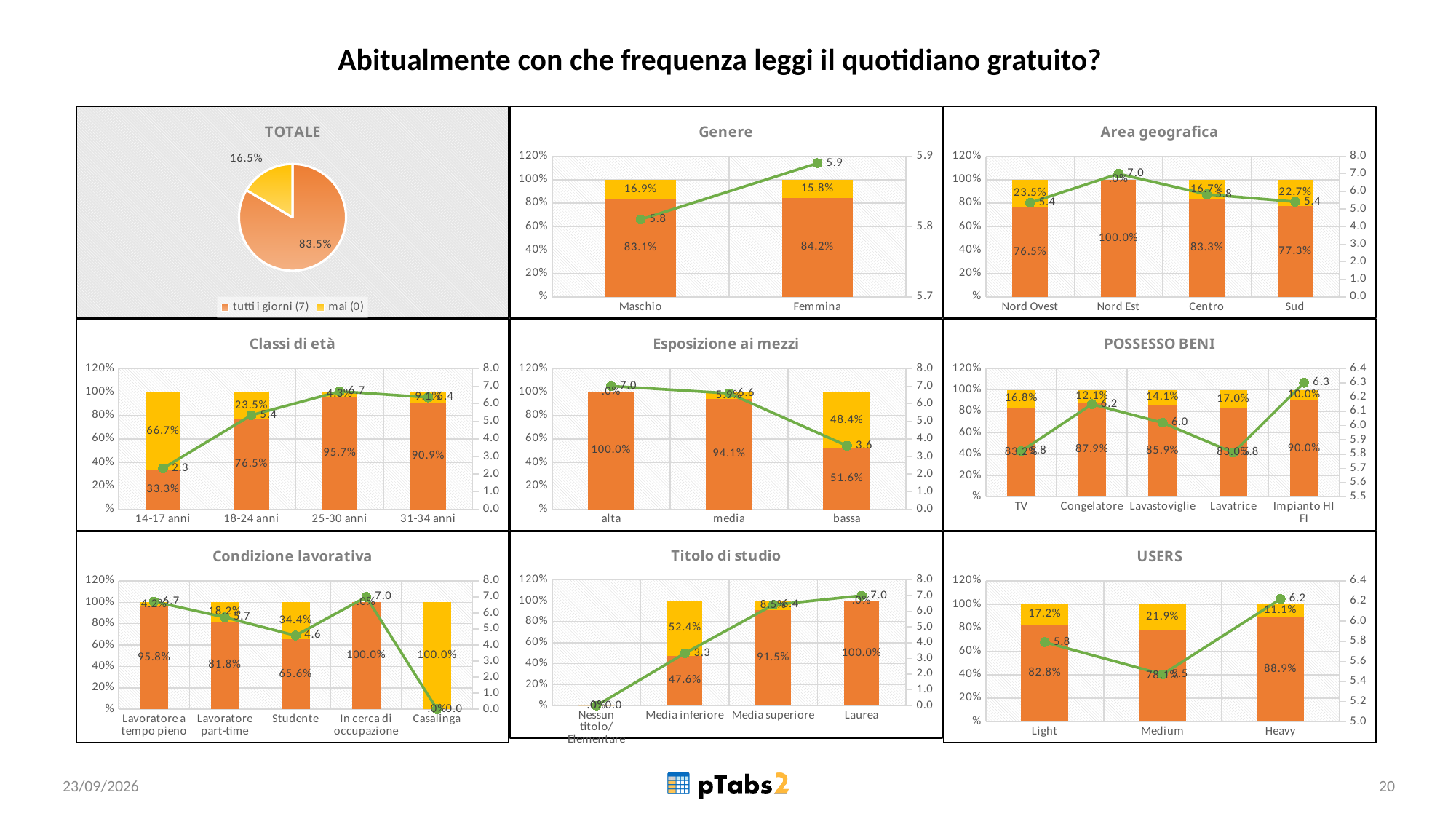
In the Area geografica chart, which category has the highest 'tutti i giorni (7)' value? Nord Est In the Classi di età chart, what is the 'mai (0)' value for 14-17 anni? 66.7% What kind of chart is the TOTALE chart? Pie chart In the Esposizione ai mezzi chart, what is the difference between the 'tutti i giorni (7)' values for alta and bassa? 48.4% In the Classi di età chart, which category has the lowest 'tutti i giorni (7)' value? 14-17 anni How many series does the legend of the TOTALE chart list? 2 In the USERS chart, what is the line value for Heavy? 6.2 In the POSSESSO BENI chart, how many categories are shown on the x axis? 5 In the Condizione lavorativa chart, what is the 'mai (0)' value for Studente? 34.4% In the Titolo di studio chart, which is larger, the 'tutti i giorni (7)' value for Media inferiore or for Media superiore? Media superiore In the TOTALE pie chart, what share is labelled for 'tutti i giorni (7)'? 83.5% In the Genere chart, what is the 'tutti i giorni (7)' value for Femmina? 84.2%